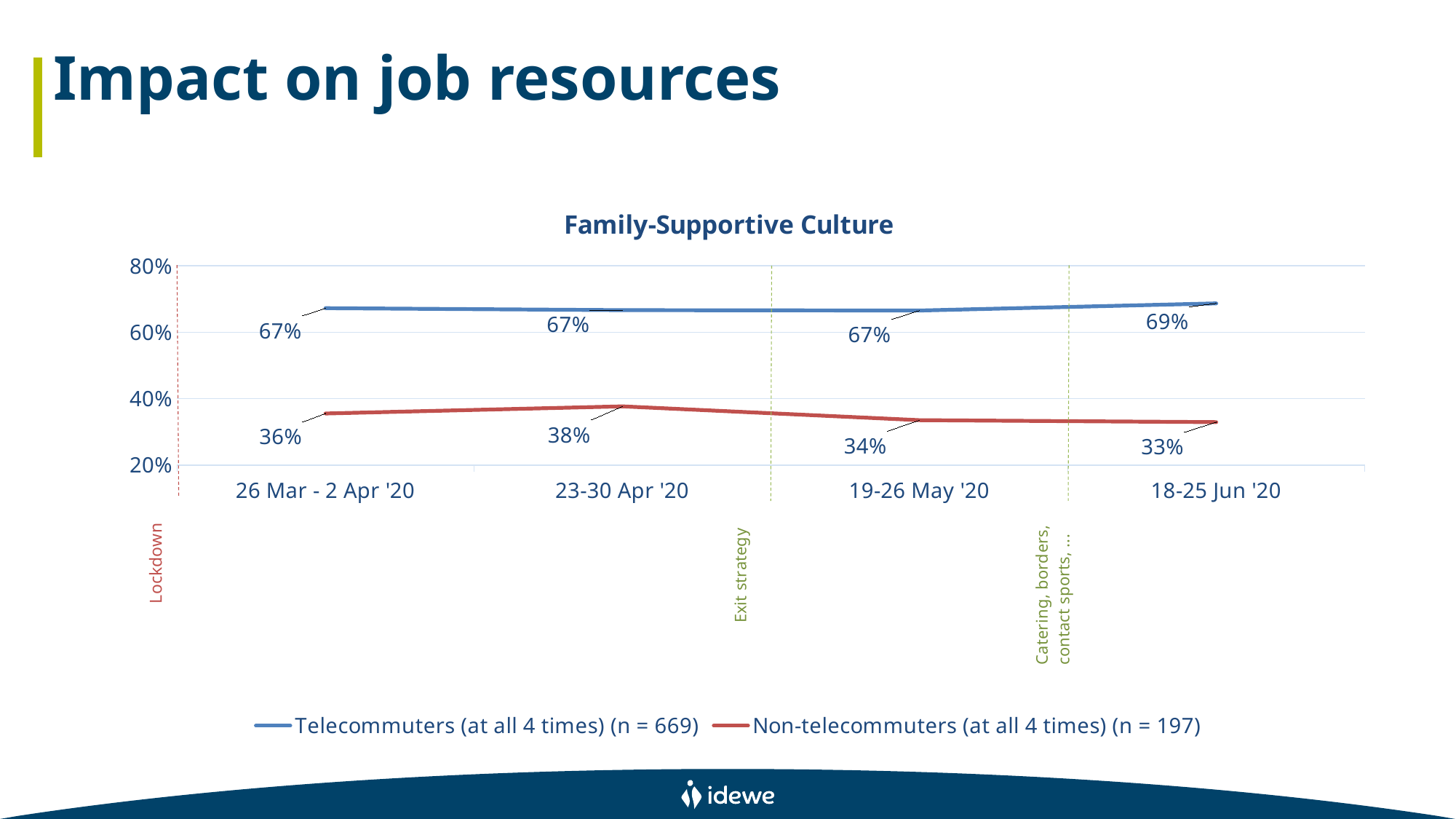
What is the difference between the Telecommuters and Non-telecommuters values in the 19-26 May '20 period? 33% What kind of chart is shown? Line chart In which period is the Non-telecommuters value highest? 23-30 Apr '20 What is the value for Telecommuters in the 18-25 Jun '20 period? 69% What is the title of the chart? Family-Supportive Culture How many time periods are shown on the x axis? 4 In which period is the Non-telecommuters value lowest? 18-25 Jun '20 Which series has the larger value in the 23-30 Apr '20 period, Telecommuters or Non-telecommuters? Telecommuters What is the value for Telecommuters in the 26 Mar - 2 Apr '20 period? 67% How many series does the legend list? 2 What is the value for Non-telecommuters in the 23-30 Apr '20 period? 38% What is the value for Non-telecommuters in the 18-25 Jun '20 period? 33%